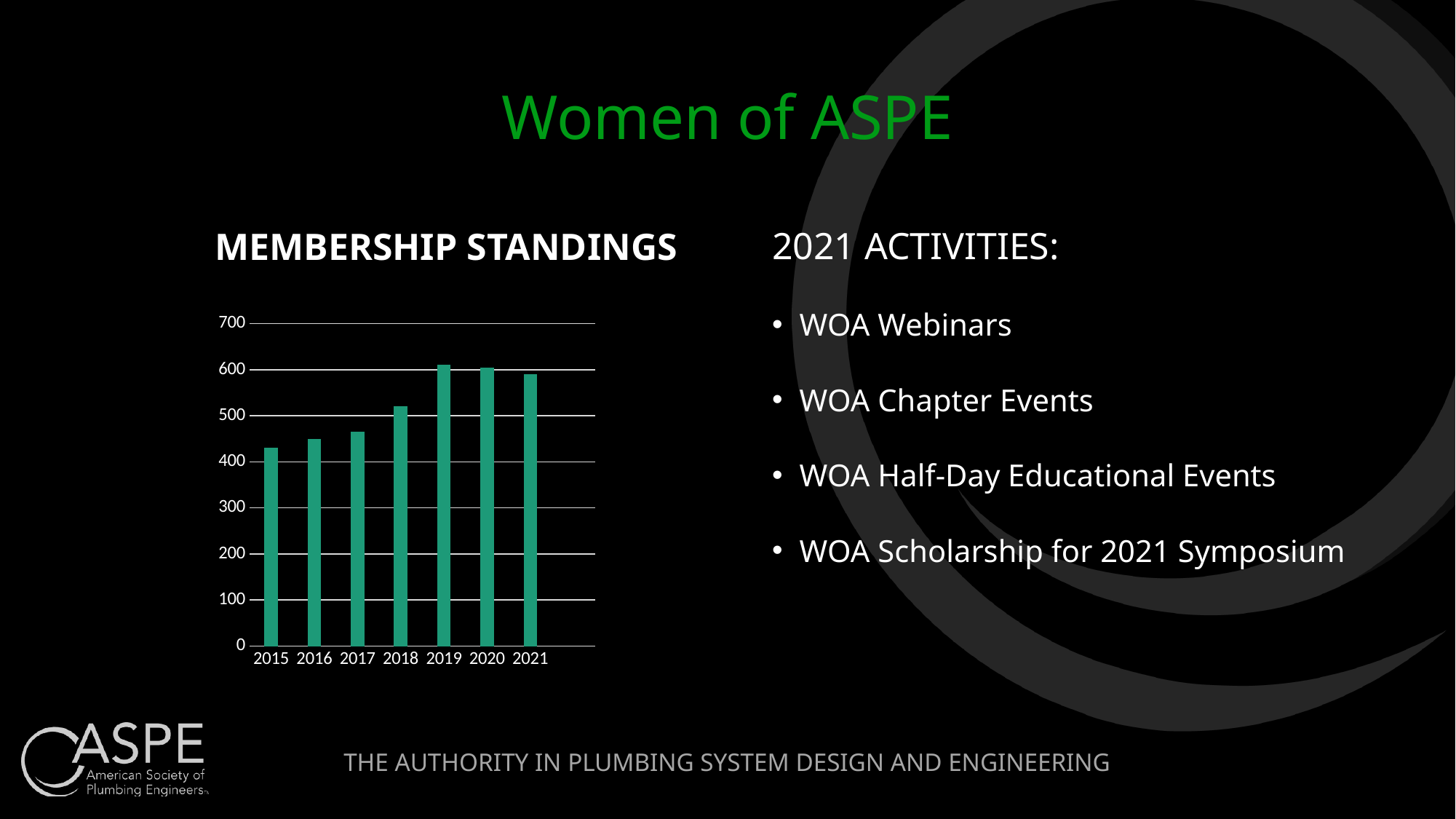
Which year has the lowest membership in the chart? 2015 Is the membership value for 2021 greater or less than 700? less Which year has the larger membership value, 2018 or 2016? 2018 How many years are shown on the x axis of the membership standings chart? 7 Is the membership value for 2015 greater or less than 500? less Which year has the larger membership value, 2015 or 2019? 2019 Is the membership value for 2017 greater or less than 500? less What kind of chart is shown under "MEMBERSHIP STANDINGS"? Bar chart Do membership values rise or fall from 2015 to 2019? Rise What is the title of the chart on the slide? MEMBERSHIP STANDINGS